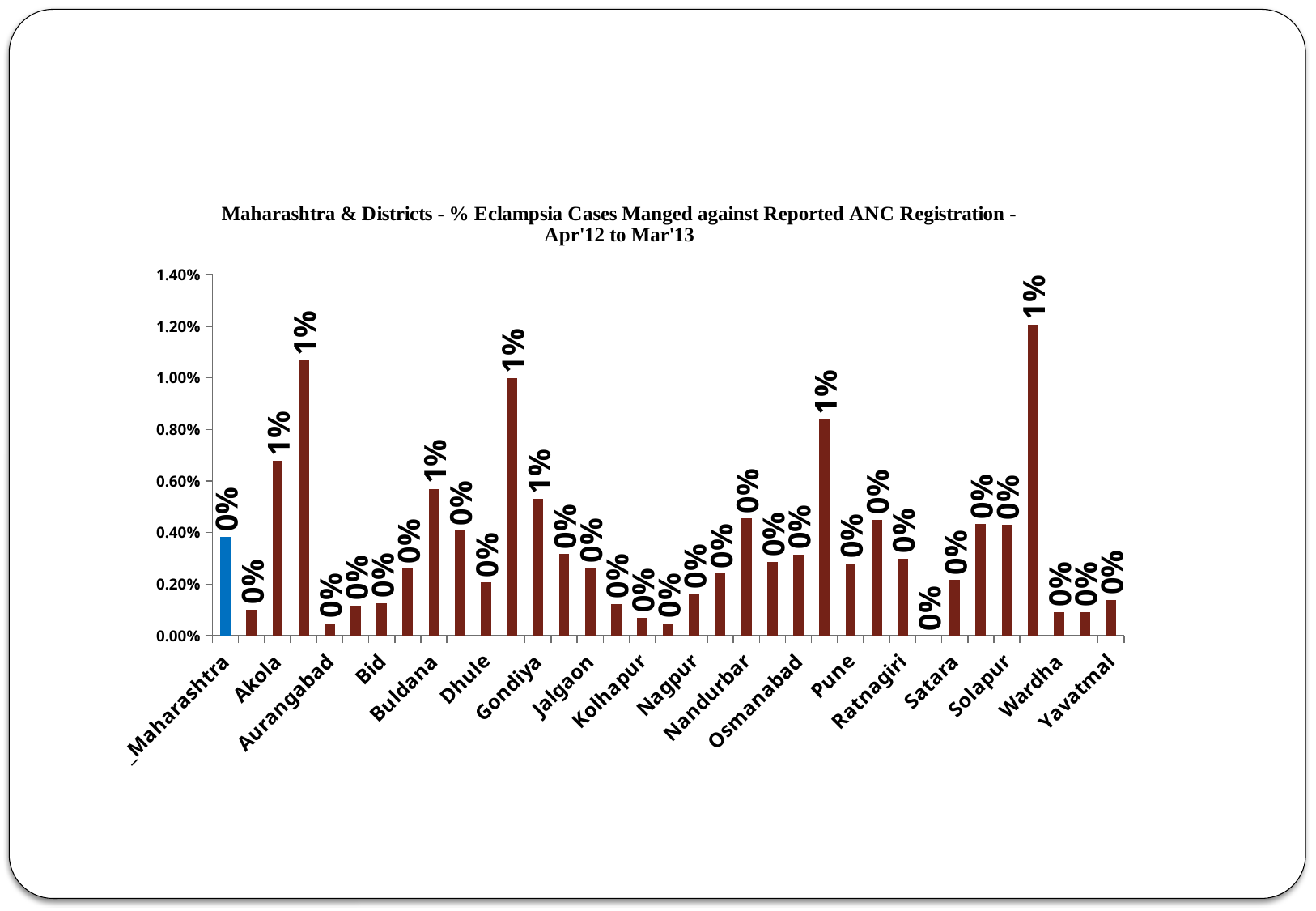
What is the data label shown above the Gondiya bar? 1% Which bar is shown in a different colour (blue) from the rest? _Maharashtra Which has a higher value, Gondiya or Kolhapur? Gondiya Is the value for Buldana greater or less than 0.40%? greater Which has a higher value, Akola or Dhule? Akola What type of chart is shown on the slide? Bar chart What is the data label shown above the _Maharashtra bar? 0% What is the data label shown above the Akola bar? 1% Is the value for Akola greater or less than 0.60%? greater Is the value for _Maharashtra greater or less than 0.20%? greater What is the data label shown above the Buldana bar? 1%